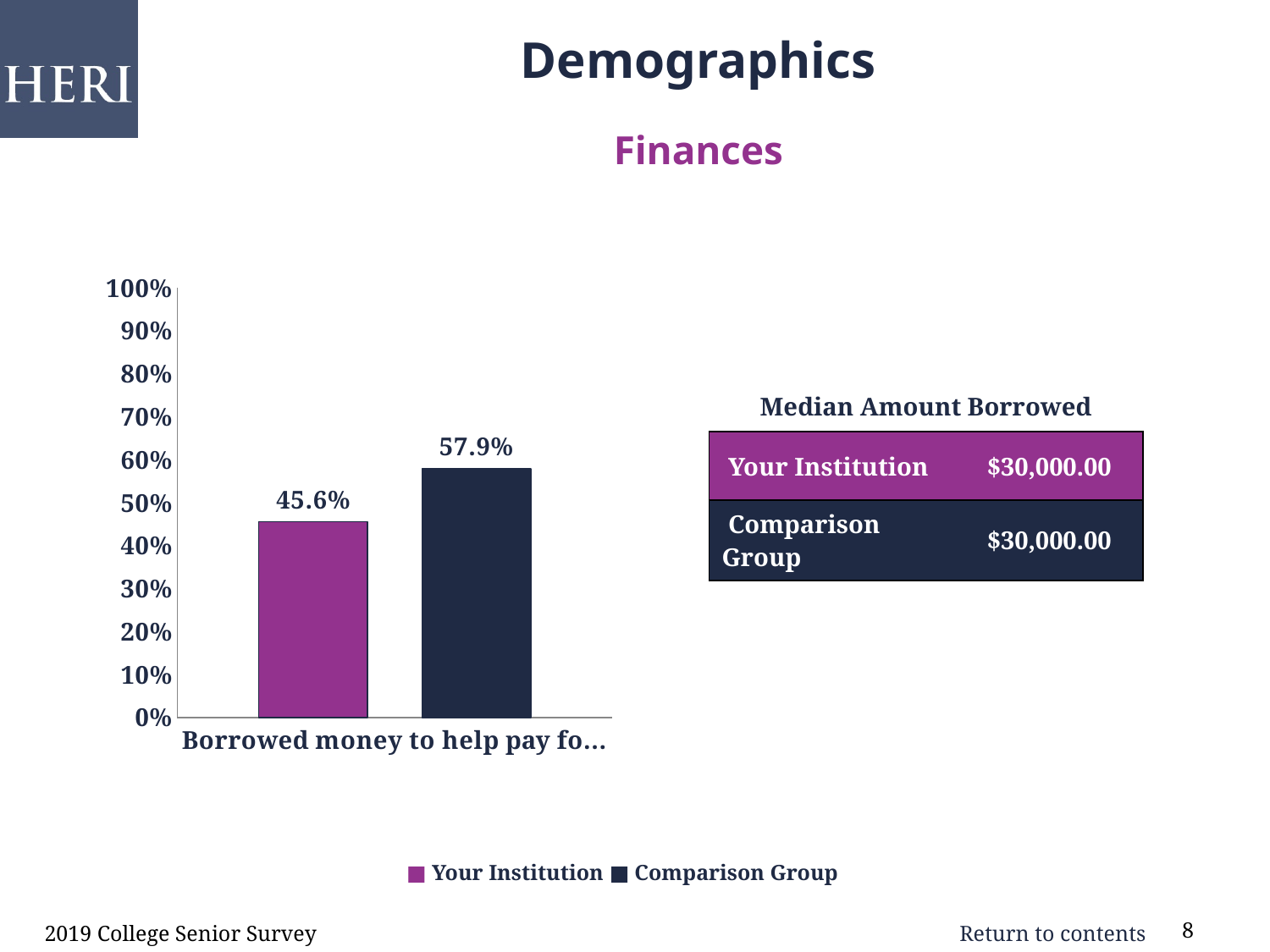
How many bars are plotted in the chart? 2 What is the maximum value shown on the y axis of the bar chart? 100% Is the value for Your Institution greater or less than 50%? less Which series has the lower value in the bar chart? Your Institution Which series has the higher value in the bar chart? Comparison Group Is the value for Comparison Group greater or less than 50%? greater What is the value for Your Institution in the bar chart? 45.6% What colour is the bar for Your Institution? purple How many series does the legend list? 2 What is the difference between the Comparison Group and Your Institution values in the bar chart? 12.3% What kind of chart is shown on the slide? bar chart What is the value for Comparison Group in the bar chart? 57.9%